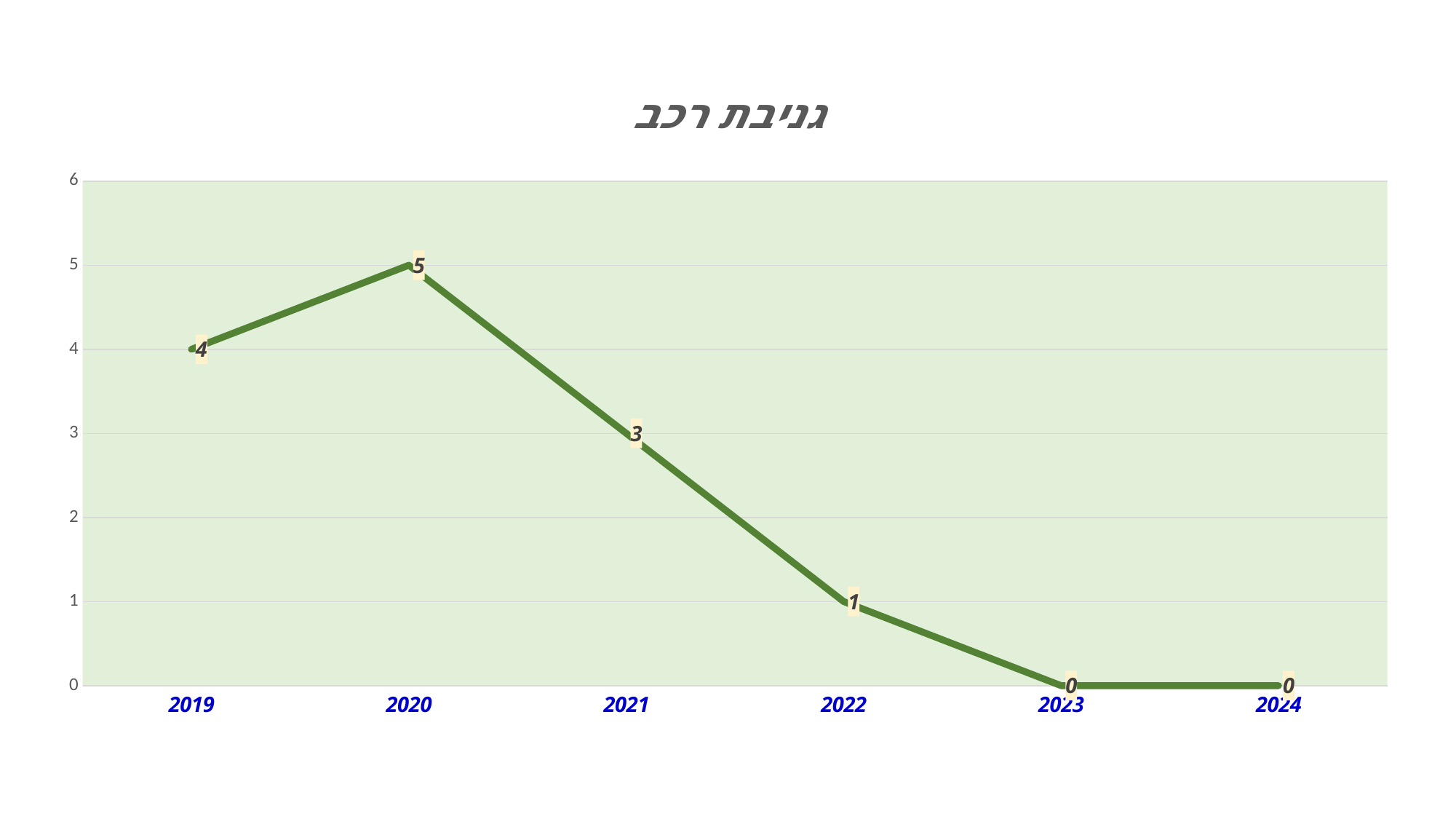
Which is larger, the value for 2019 or the value for 2021? 2019 What is the value for 2024? 0 What is the title of the chart? גניבת רכב What is the value for 2021? 3 Do the values rise or fall from 2020 to 2024? fall What is the difference between the values for 2020 and 2022? 4 Which year has the highest value? 2020 What is the value for 2019? 4 How many years are plotted on the x axis? 6 What kind of chart is shown? line chart What is the value for 2022? 1 What is the value for 2020? 5